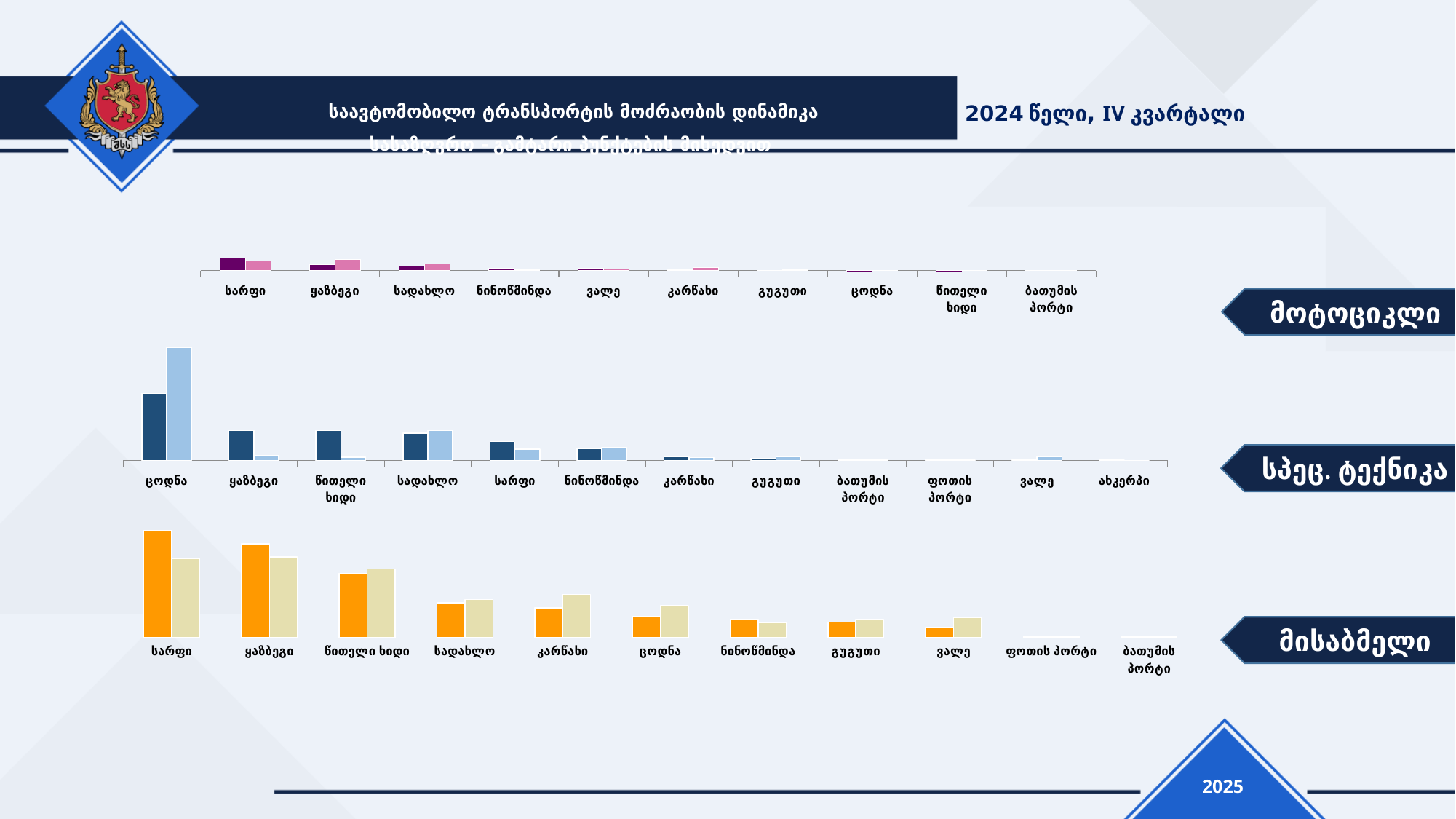
How many categories are shown on the x axis of the მისაბმელი chart? 11 In the სპეც. ტექნიკა chart, for ცოდნა, which bar is taller: the dark blue or the light blue one? light blue In the მოტოციკლი chart, which category has the tallest bars? სარფი What kind of chart is the მოტოციკლი chart? bar chart How many bars are drawn for each category in the მისაბმელი chart? 2 In the მისაბმელი chart, which has the taller orange bar: ყაზბეგი or წითელი ხიდი? ყაზბეგი In the მისაბმელი chart, which category has the tallest bar? სარფი How many categories are shown on the x axis of the სპეც. ტექნიკა chart? 12 How many categories are shown on the x axis of the მოტოციკლი chart? 10 In the სპეც. ტექნიკა chart, which category has the tallest bar? ცოდნა What kind of chart is the მისაბმელი chart? bar chart In the მისაბმელი chart, which has the taller orange bar: სარფი or ყაზბეგი? სარფი